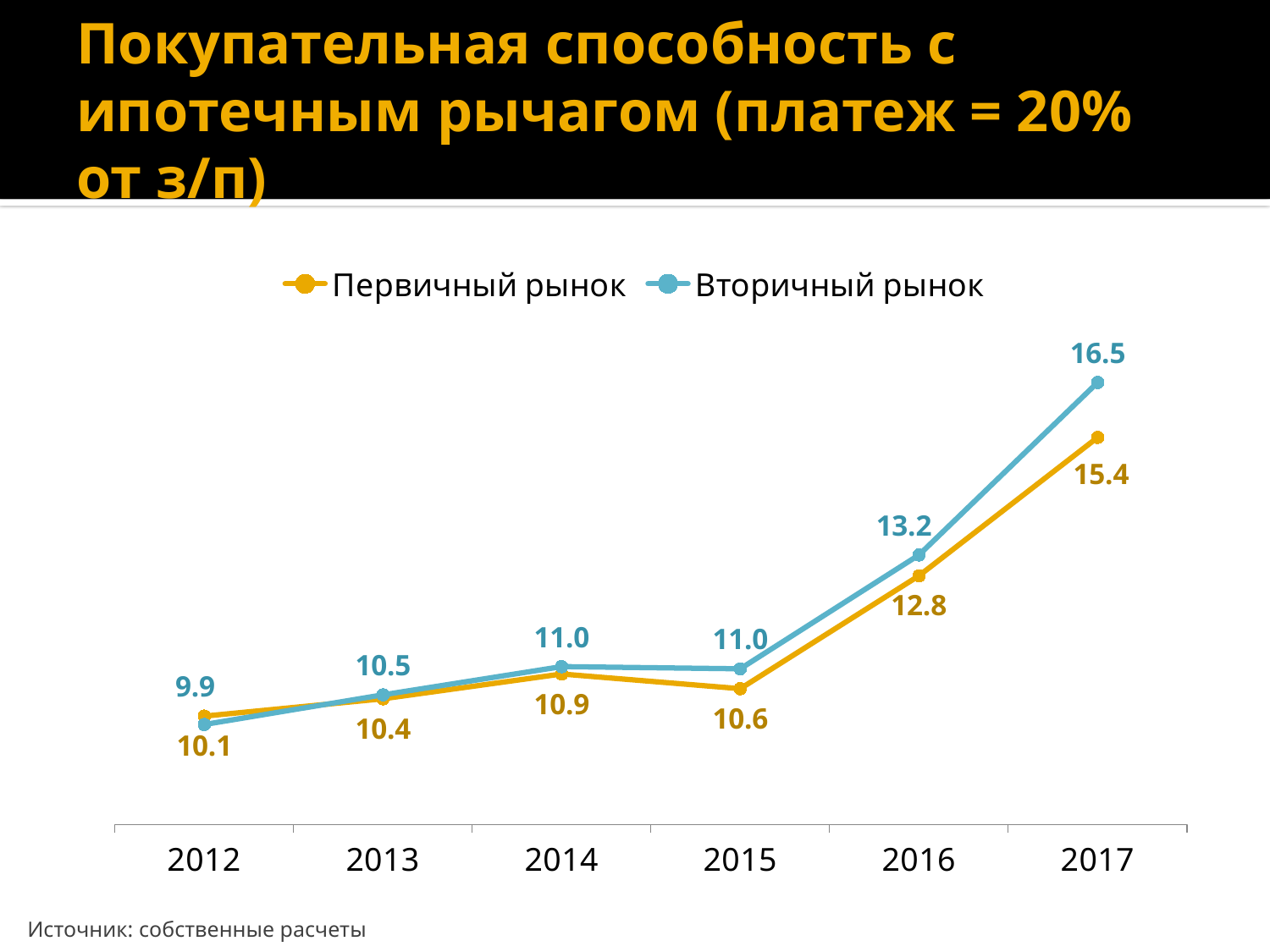
What is the value for Первичный рынок in 2012? 10.1 How many years are shown on the x axis? 6 What kind of chart is shown on the slide? line chart What is the value for Первичный рынок in 2016? 12.8 Which series has the larger value in 2016, Первичный рынок or Вторичный рынок? Вторичный рынок What is the value for Вторичный рынок in 2017? 16.5 Does the value for Вторичный рынок rise or fall from 2015 to 2017? rise In which year is the value for Первичный рынок lowest? 2012 What is the value for Вторичный рынок in 2015? 11.0 How many series does the legend list? 2 What is the difference between Вторичный рынок and Первичный рынок in 2017? 1.1 In which year is the value for Вторичный рынок highest? 2017